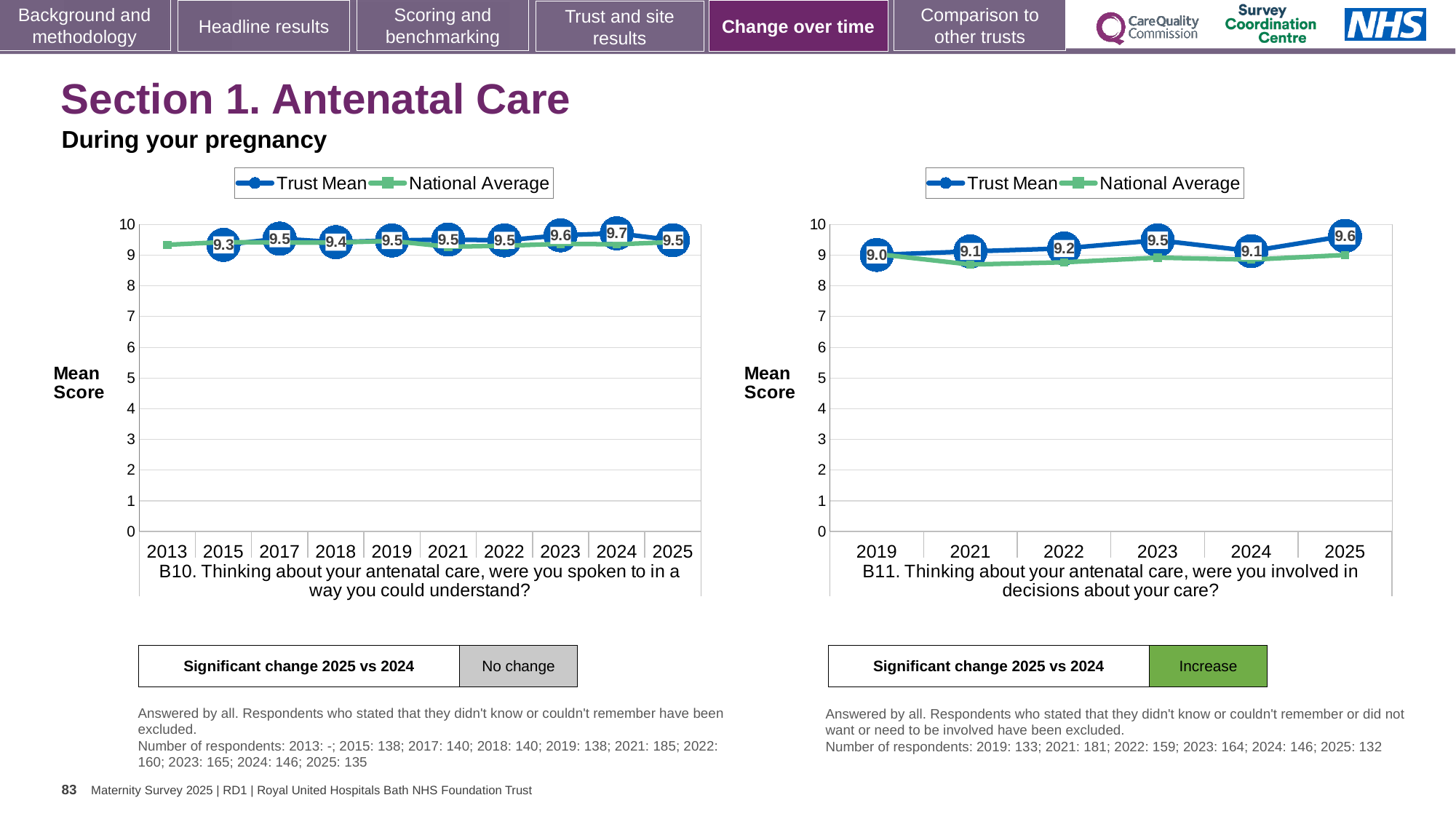
In the B10 chart on the left, what is the Trust Mean for 2015? 9.3 How many years are shown on the x axis of the B11 chart on the right? 6 In the B11 chart on the right, what is the Trust Mean for 2019? 9.0 In the B10 chart on the left, is the Trust Mean for 2024 larger or smaller than the Trust Mean for 2025? larger In the B11 chart on the right, what is the Trust Mean for 2025? 9.6 In the B11 chart on the right, which year has the lowest Trust Mean? 2019 How many series does the legend of the B10 chart on the left list? 2 In the B11 chart on the right, is the National Average for 2021 greater or less than 9? less In the B10 chart on the left, which year has the highest Trust Mean? 2024 What kind of chart is the B11 chart on the right? line chart In the B11 chart on the right, what is the difference between the Trust Mean for 2025 and the Trust Mean for 2024? 0.5 In the B10 chart on the left, what is the Trust Mean for 2024? 9.7